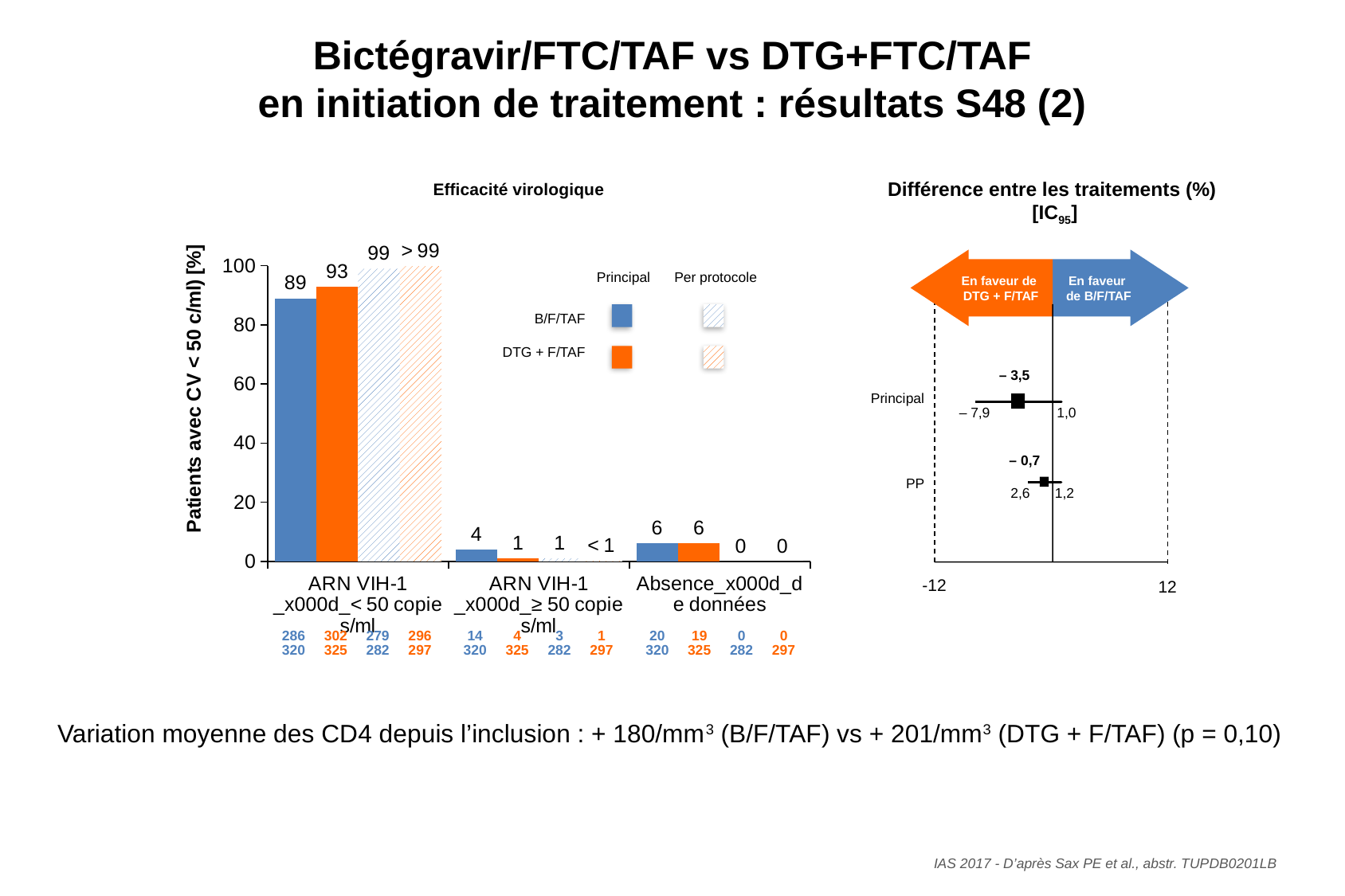
In the 'Efficacité virologique' chart, what is the value for B/F/TAF (Principal) in the 'ARN VIH-1 ≥ 50 copies/ml' category? 4 In the 'Efficacité virologique' chart, what is the value for DTG + F/TAF (Principal) in the 'Absence de données' category? 6 In the 'Efficacité virologique' chart, how many categories are shown on the x axis? 3 In the 'Différence entre les traitements (%)' chart, what is the point estimate for the Principal analysis? – 3,5 In the 'Différence entre les traitements (%)' chart, what is the point estimate for the PP analysis? – 0,7 In the 'Efficacité virologique' chart, what is the value for DTG + F/TAF (Principal) in the 'ARN VIH-1 < 50 copies/ml' category? 93 What kind of chart is the 'Efficacité virologique' chart? Bar chart In the 'Efficacité virologique' chart, what is the y-axis label? Patients avec CV < 50 c/ml) [%] In the 'Efficacité virologique' chart, what is the value for B/F/TAF (Principal) in the 'ARN VIH-1 < 50 copies/ml' category? 89 In the 'Efficacité virologique' chart, what is the difference between the DTG + F/TAF (Principal) and B/F/TAF (Principal) values in the 'ARN VIH-1 < 50 copies/ml' category? 4 In the 'Efficacité virologique' chart, which is larger in the 'ARN VIH-1 ≥ 50 copies/ml' category: B/F/TAF (Principal) or DTG + F/TAF (Principal)? B/F/TAF (Principal) In the 'Efficacité virologique' chart, what is the value for B/F/TAF (Per protocole) in the 'ARN VIH-1 < 50 copies/ml' category? 99